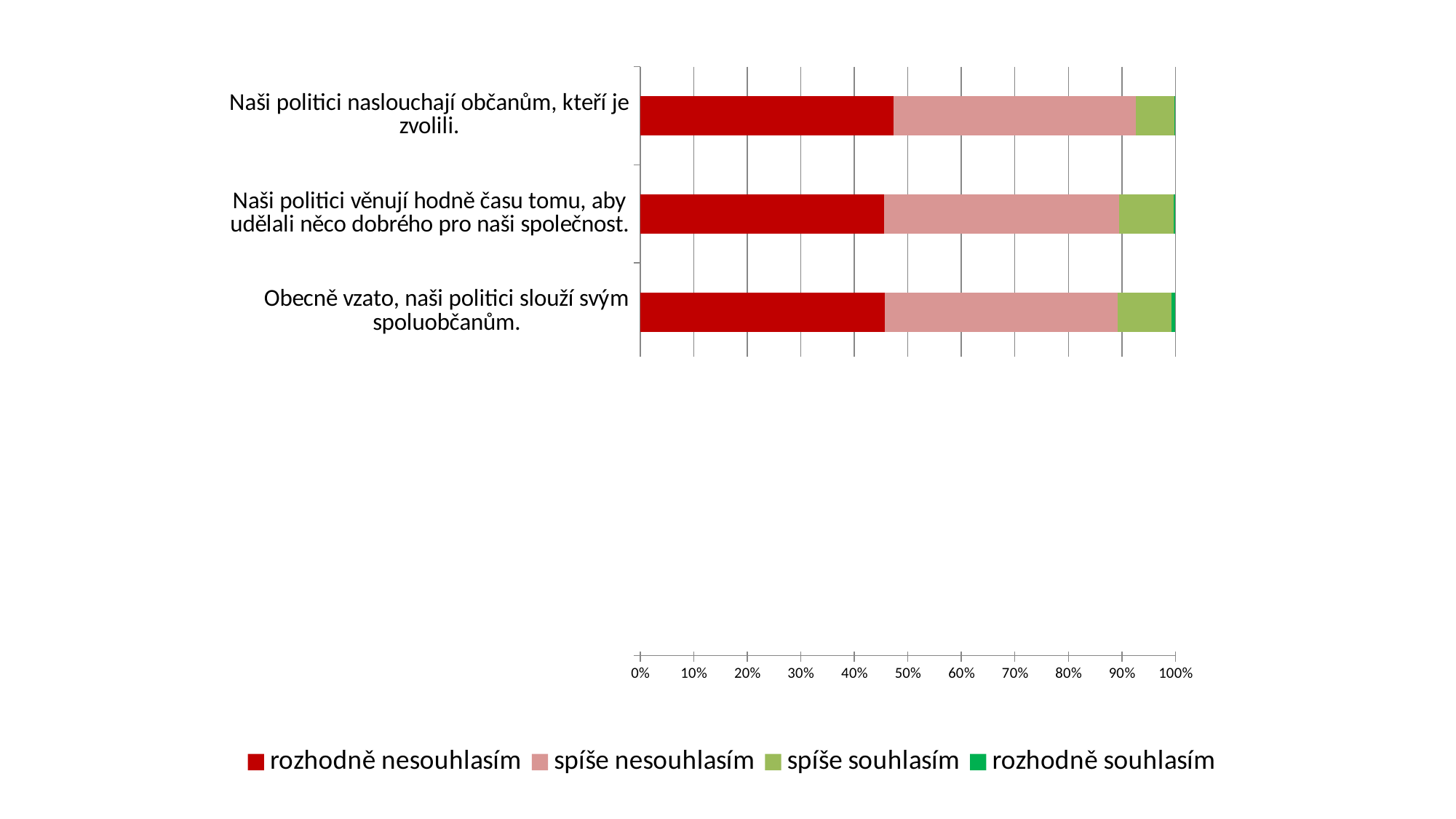
Is the 'spíše souhlasím' value for 'Naši politici naslouchají občanům, kteří je zvolili.' greater or less than 10%? less Is the 'rozhodně nesouhlasím' value for 'Naši politici naslouchají občanům, kteří je zvolili.' greater or less than 40%? greater What is the highest value shown on the horizontal axis? 100% What kind of chart is shown on the slide? stacked bar chart Is the 'rozhodně nesouhlasím' value for 'Obecně vzato, naši politici slouží svým spoluobčanům.' greater or less than 40%? greater How many statements (categories) are plotted on the chart? 3 Which series is shown in dark red in the legend? rozhodně nesouhlasím How many series does the legend list? 4 What is the last entry in the chart legend? rozhodně souhlasím